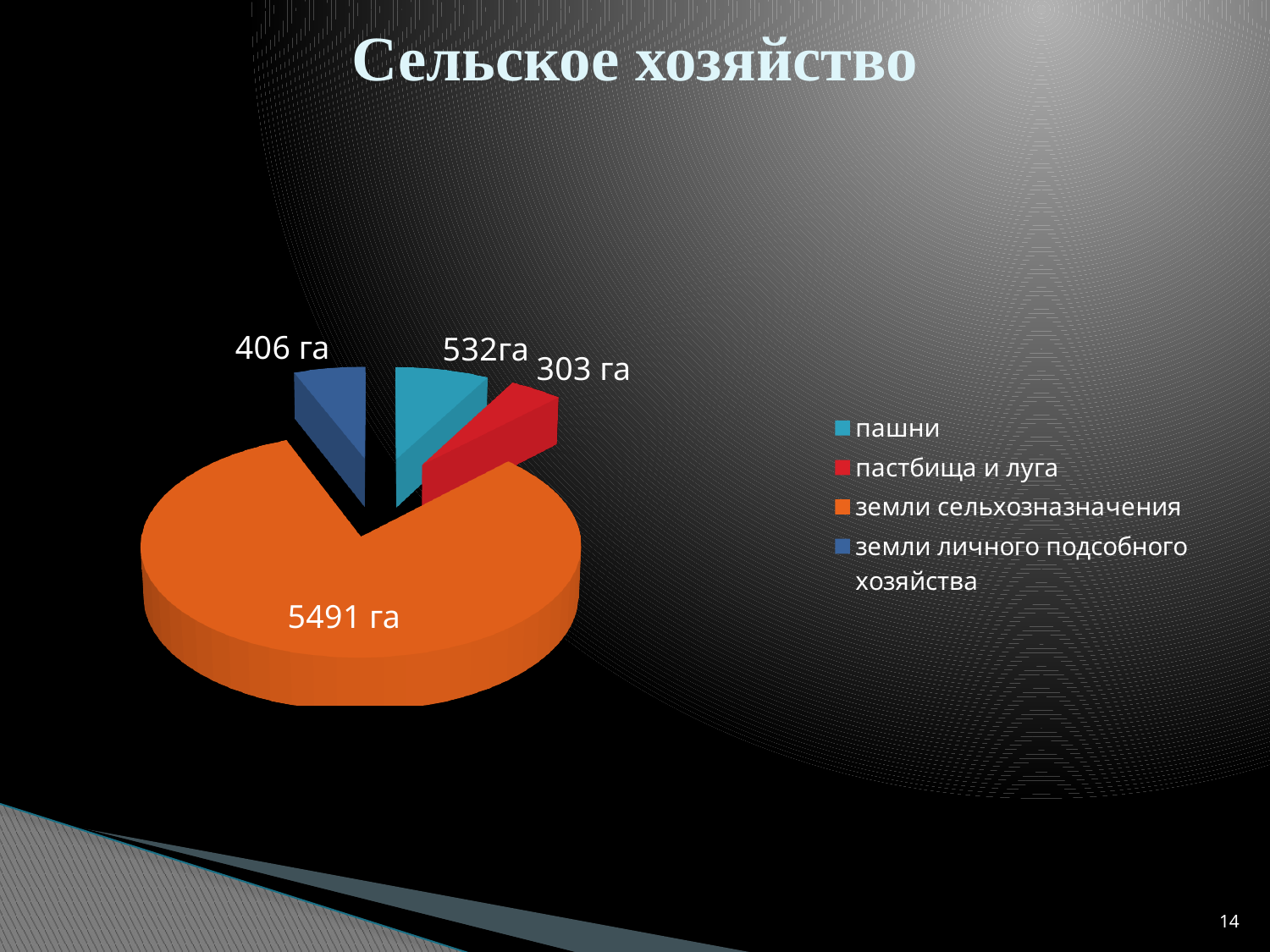
How many categories does the pie chart have? 4 What is the difference between земли личного подсобного хозяйства and пастбища и луга? 103 га Which is larger, пашни or земли личного подсобного хозяйства? пашни What type of chart is shown on the slide? pie chart Which category has the largest slice of the pie? земли сельхозназначения What colour is the slice for пастбища и луга? red What is the value for пастбища и луга? 303 га What is the value for пашни? 532га What is the value for земли личного подсобного хозяйства? 406 га What is the difference between земли сельхозназначения and пашни? 4959 га Which category has the smallest slice of the pie? пастбища и луга What is the value for земли сельхозназначения? 5491 га